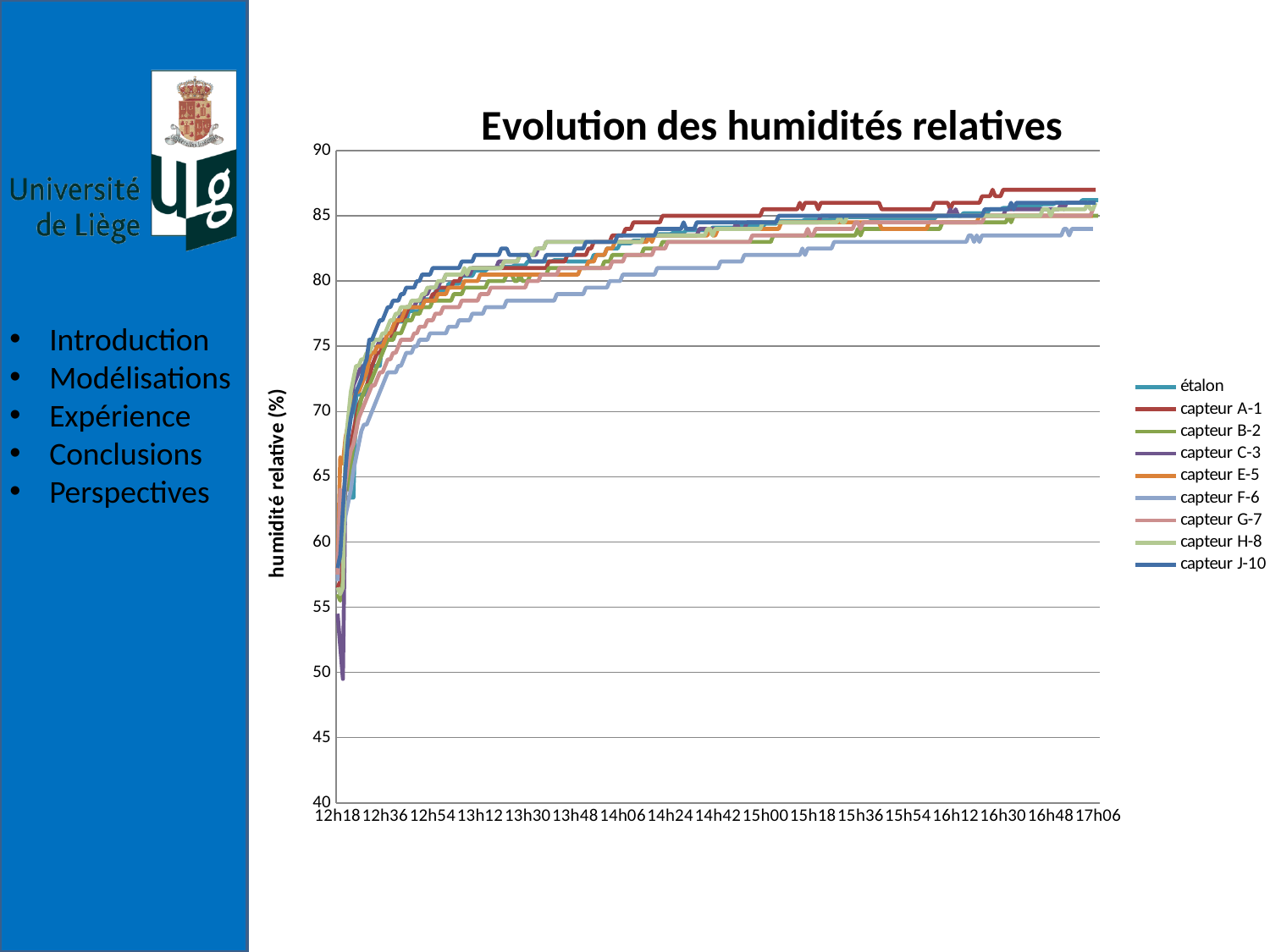
What is the title of the chart? Evolution des humidités relatives What is the label of the vertical axis? humidité relative (%) Which series shows the lowest value at the very start of the recording, dipping below 50? capteur C-3 Is the value for capteur F-6 at 17h06 greater or less than 85? less Which series has the highest value at the end of the recording (17h06)? capteur A-1 What kind of chart is shown on the slide? line chart Which series has the lowest value at the end of the recording (17h06)? capteur F-6 How many series does the chart's legend list? 9 Do the humidity values generally rise or fall over time along the x axis? rise Is the value for capteur A-1 at 17h06 greater or less than 85? greater At 17h06, which is larger: the value for capteur A-1 or the value for capteur F-6? capteur A-1